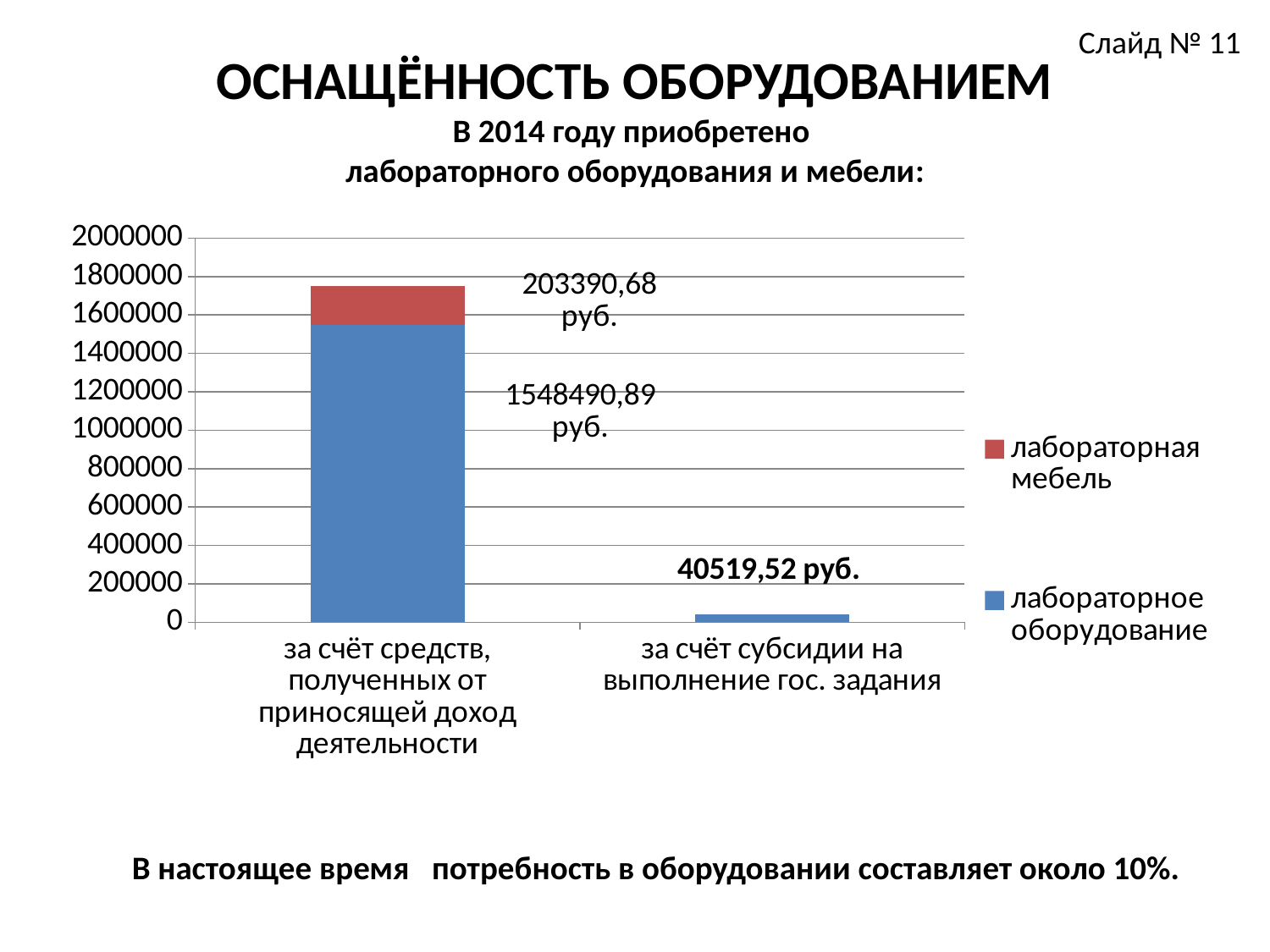
Is the total bar for 'за счёт средств, полученных от приносящей доход деятельности' greater or less than 1600000? greater What is the value of лабораторное оборудование for the category 'за счёт средств, полученных от приносящей доход деятельности'? 1548490,89 руб. What is the total of the stacked bar for 'за счёт средств, полученных от приносящей доход деятельности'? 1751881,57 руб. What is the value of лабораторное оборудование for the category 'за счёт субсидии на выполнение гос. задания'? 40519,52 руб. Which series is shown in red in the legend? лабораторная мебель How many series does the legend list? 2 What type of chart is shown on the slide? Stacked bar chart How many categories are shown on the x axis? 2 Which category has the lower total bar height? за счёт субсидии на выполнение гос. задания What is the difference between the лабораторное оборудование values of the two categories? 1507971,37 руб. Which category has the higher value for лабораторное оборудование? за счёт средств, полученных от приносящей доход деятельности What is the value of лабораторная мебель for the category 'за счёт средств, полученных от приносящей доход деятельности'? 203390,68 руб.